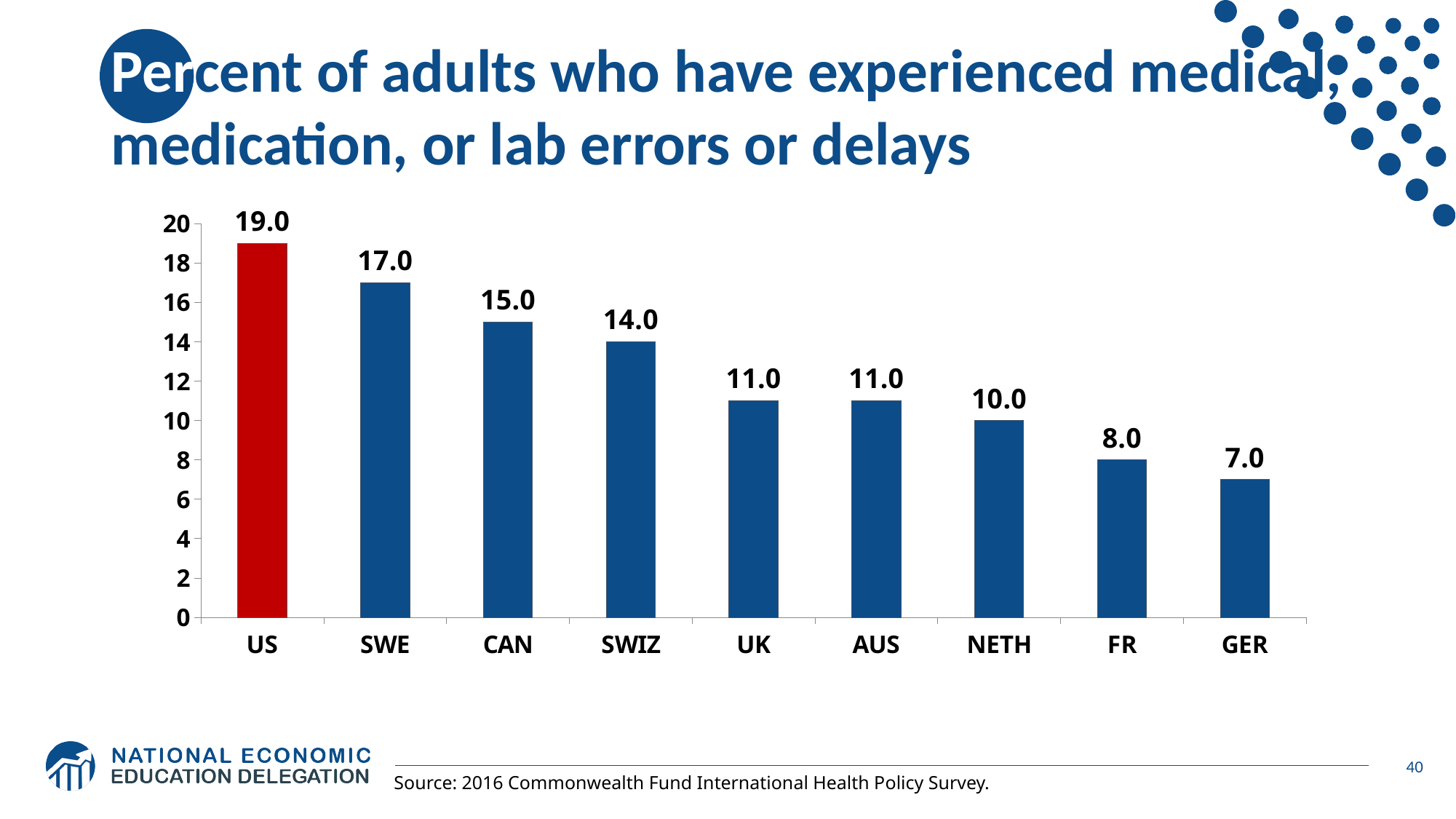
Do the values rise or fall from left to right across the chart? fall Which bar is coloured red rather than blue? US Which country has the highest value? US How many countries are shown on the chart? 9 What is the difference between the values for the US and GER? 12.0 What is the value for NETH? 10.0 What kind of chart is shown on the slide? bar chart What is the difference between the values for SWE and CAN? 2.0 Which country has the lowest value? GER What is the value for the US? 19.0 What is the value for SWIZ? 14.0 Which is larger, the value for CAN or the value for FR? CAN